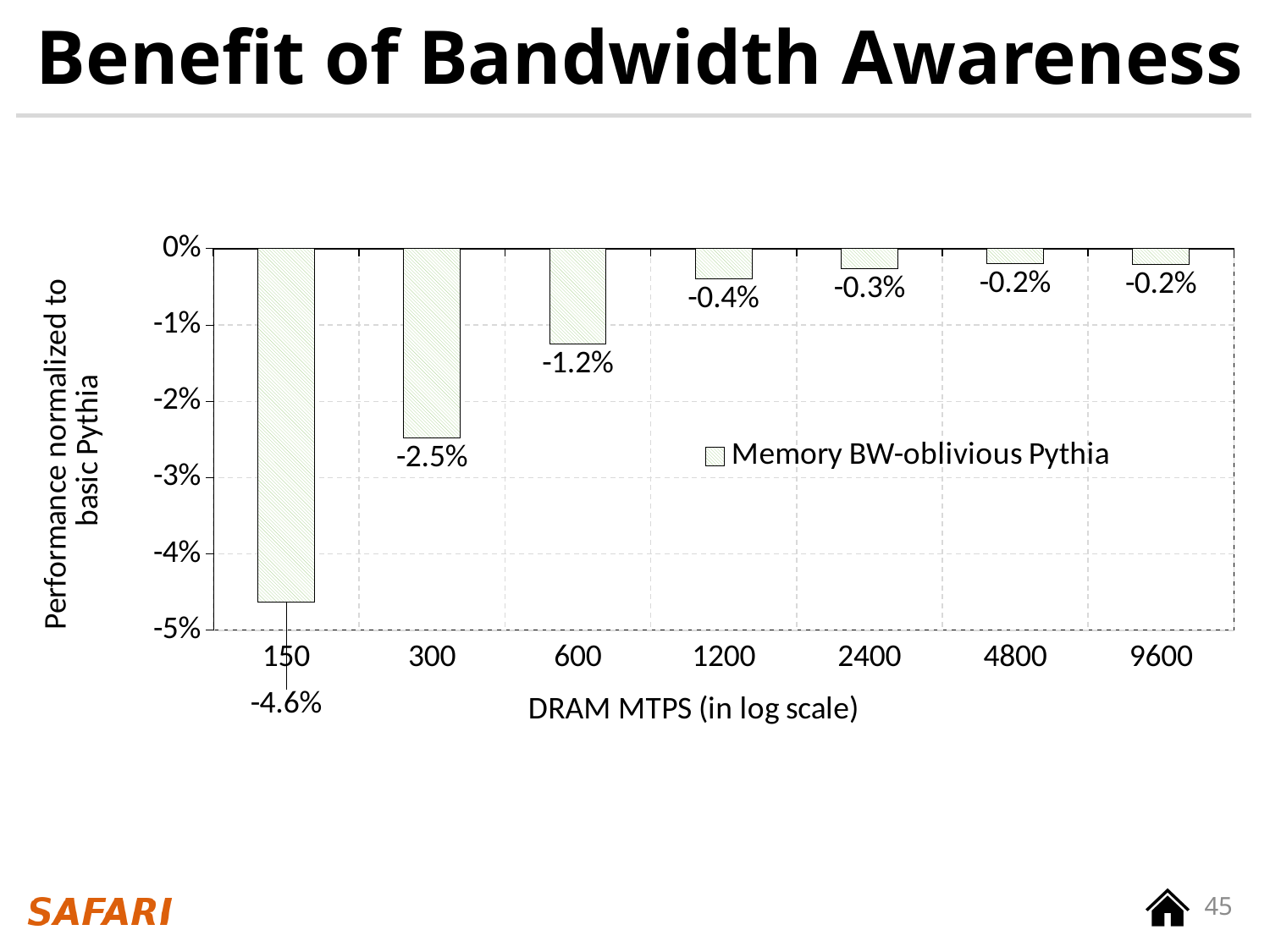
What is the difference between the values for DRAM MTPS 150 and 300? 2.1% Is the value for DRAM MTPS 150 greater or less than -4%? less How many series does the legend list? 1 What is the series name shown in the legend? Memory BW-oblivious Pythia Which has the larger performance loss, DRAM MTPS 300 or 600? 300 How many DRAM MTPS categories are shown on the x axis? 7 Which DRAM MTPS category has the lowest (most negative) value? 150 What kind of chart is shown on the slide? bar chart What is the value for DRAM MTPS 600? -1.2% Do the values rise or fall as DRAM MTPS increases along the x axis? rise What is the value for DRAM MTPS 150? -4.6% What is the value for DRAM MTPS 2400? -0.3%